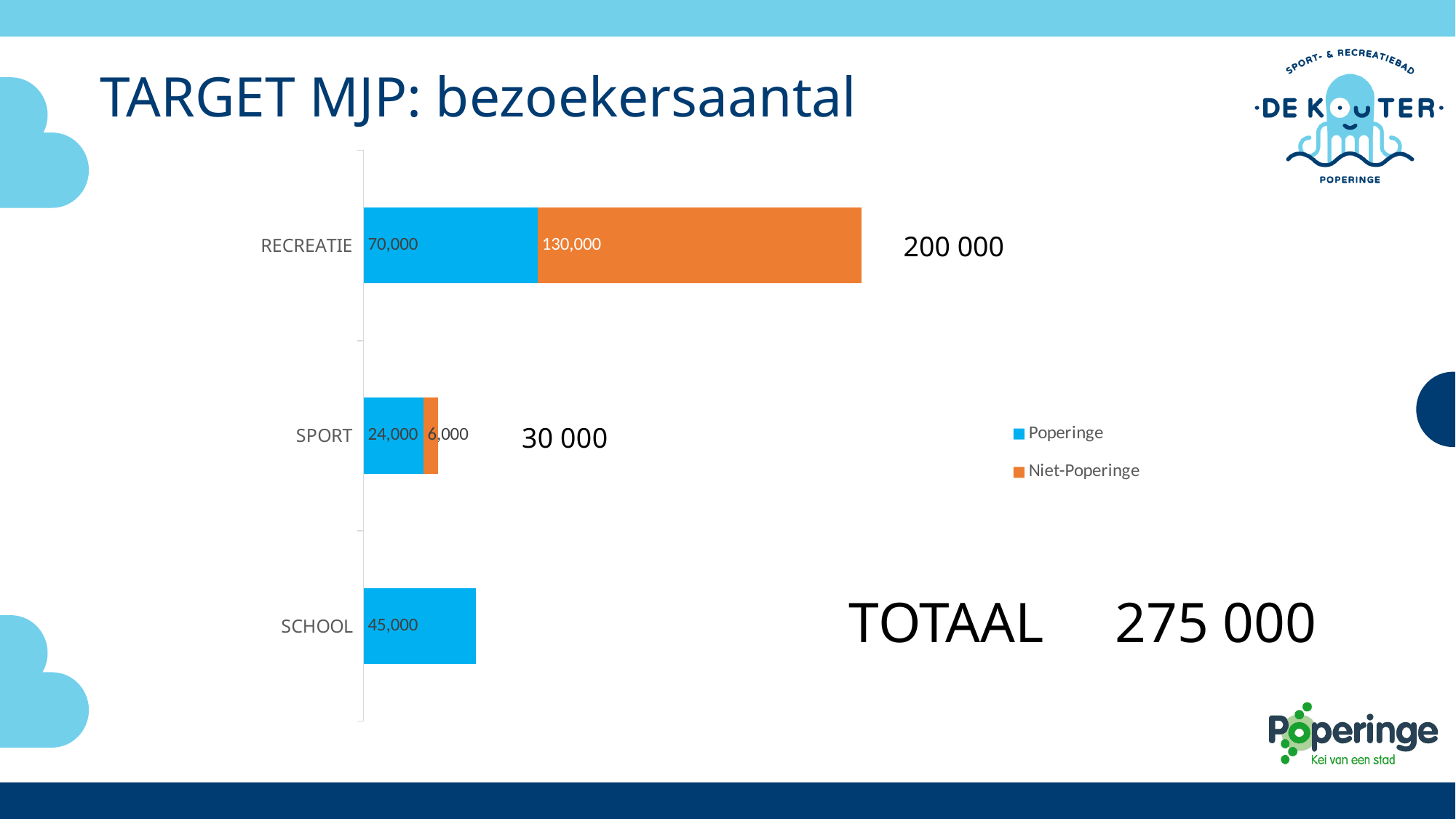
Which category has the highest Poperinge value? RECREATIE What is the Niet-Poperinge value for SPORT? 6,000 How many series does the legend list? 2 What is the Poperinge value for SCHOOL? 45,000 What is the difference between the Niet-Poperinge and Poperinge values for RECREATIE? 60,000 Which category has the lowest Poperinge value? SPORT What is the total of the stacked bar for SPORT? 30,000 How many categories are shown on the chart? 3 What is the Poperinge value for SPORT? 24,000 What is the Niet-Poperinge value for RECREATIE? 130,000 What is the Poperinge value for RECREATIE? 70,000 Which is larger for SPORT: the Poperinge value or the Niet-Poperinge value? Poperinge